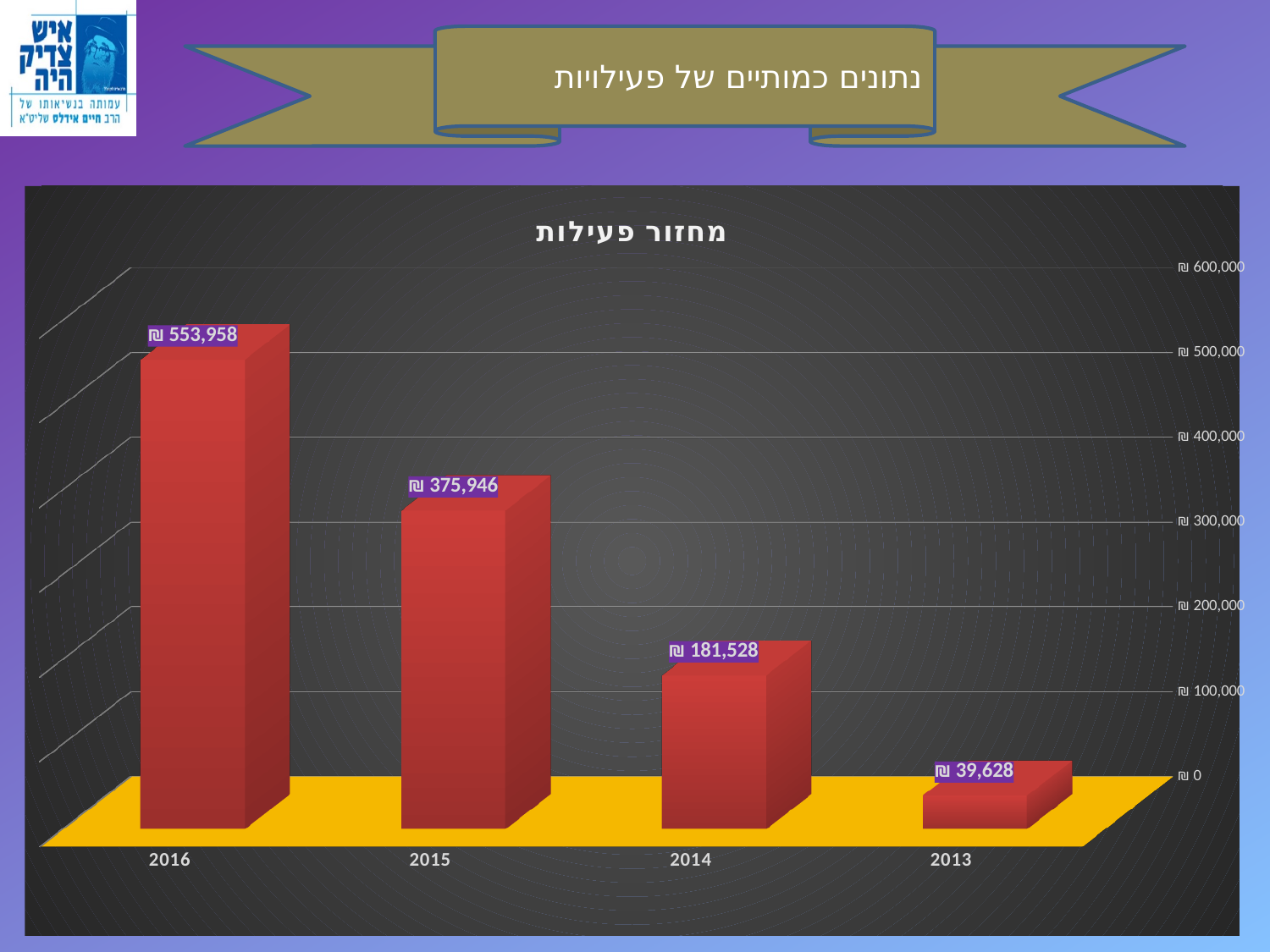
How many years are shown on the chart? 4 What is the value for 2014? ₪ 181,528 What is the difference between the values for 2016 and 2015? ₪ 178,012 Which year has the highest value? 2016 Is the value for 2015 greater or less than ₪ 400,000? less What is the value for 2015? ₪ 375,946 What kind of chart is shown on the slide? bar chart What is the difference between the values for 2014 and 2013? ₪ 141,900 What is the value for 2016? ₪ 553,958 What is the value for 2013? ₪ 39,628 Which is larger, the value for 2015 or the value for 2014? 2015 Which year has the lowest value? 2013